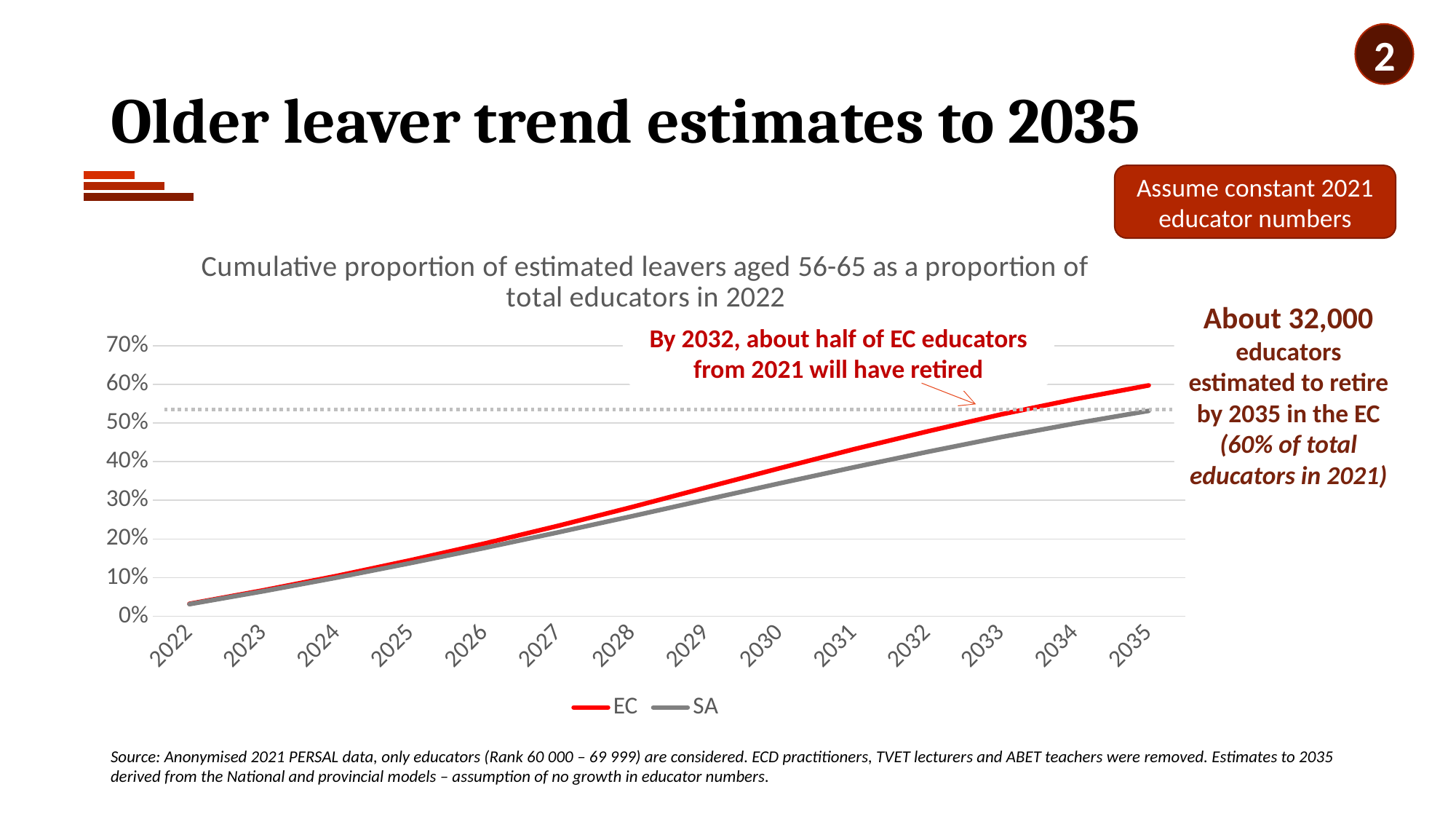
How many years are shown along the x axis of the chart? 14 Is the value for SA in 2026 greater or less than 20%? less In 2033, which series has the higher value, EC or SA? EC Is the value for SA in 2035 greater or less than 60%? less Which series is drawn in red on the chart? EC Do the values for EC rise or fall from 2022 to 2035? rise Do the values for SA rise or fall from 2022 to 2035? rise Is the value for EC in 2028 greater or less than 30%? less In 2035, which series has the higher value, EC or SA? EC How many series does the chart legend list? 2 What kind of chart is shown on the slide? line chart